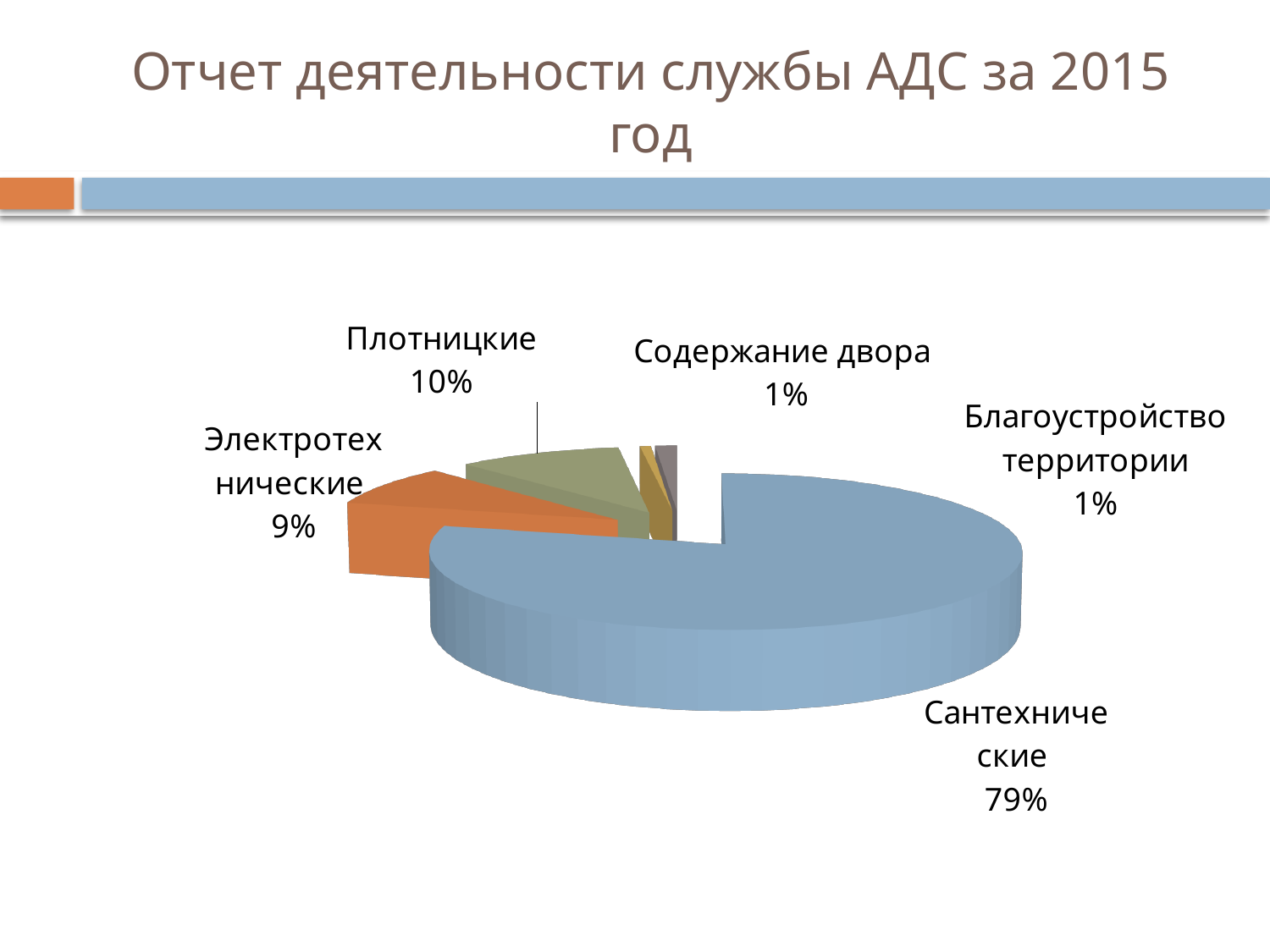
What share of the pie does Благоустройство территории have? 1% What kind of chart is shown on the slide? pie chart What is the difference in percentage points between Сантехнические and Плотницкие? 69 Which category has the largest share of the pie? Сантехнические What is the title of the slide containing the chart? Отчет деятельности службы АДС за 2015 год What share of the pie does Сантехнические have? 79% How many categories (slices) does the pie chart have? 5 What share of the pie does Содержание двора have? 1% Which is larger, the share for Плотницкие or the share for Электротехнические? Плотницкие What is the difference in percentage points between Плотницкие and Электротехнические? 1